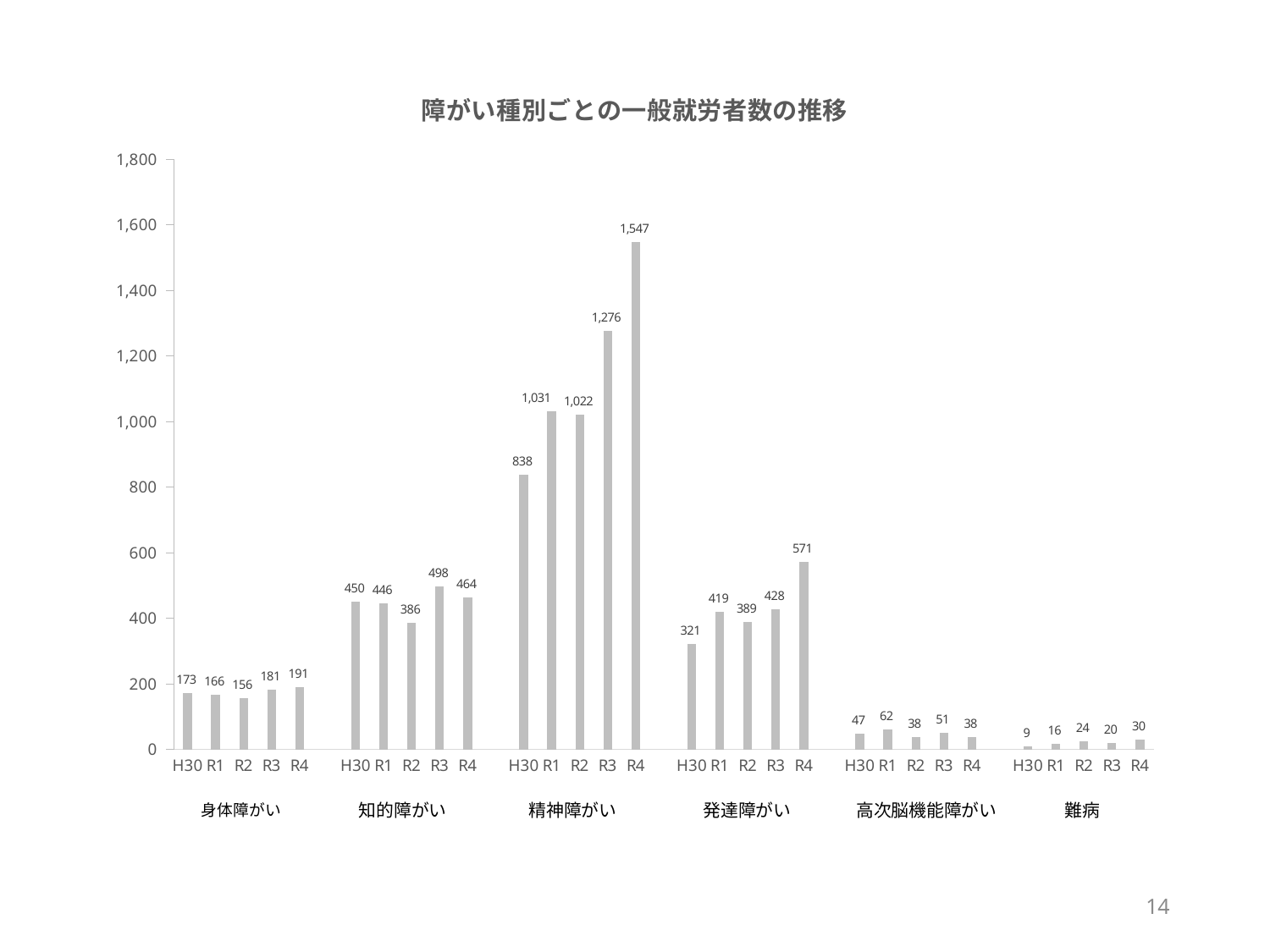
Which is larger: 知的障がい in R3 or 知的障がい in R4? 知的障がい in R3 What kind of chart is shown on the slide? bar chart What is the difference between the 発達障がい values for R4 and H30? 250 Which bar on the chart has the lowest value? 難病 H30 What is the value for 精神障がい in R4? 1,547 What is the title of the chart? 障がい種別ごとの一般就労者数の推移 What is the value for 身体障がい in H30? 173 What is the value for 高次脳機能障がい in R1? 62 How many disability categories are shown on the x axis? 6 Which bar on the chart has the highest value? 精神障がい R4 Is the value for 精神障がい in R3 greater or less than 1,200? greater What is the value for 難病 in R2? 24